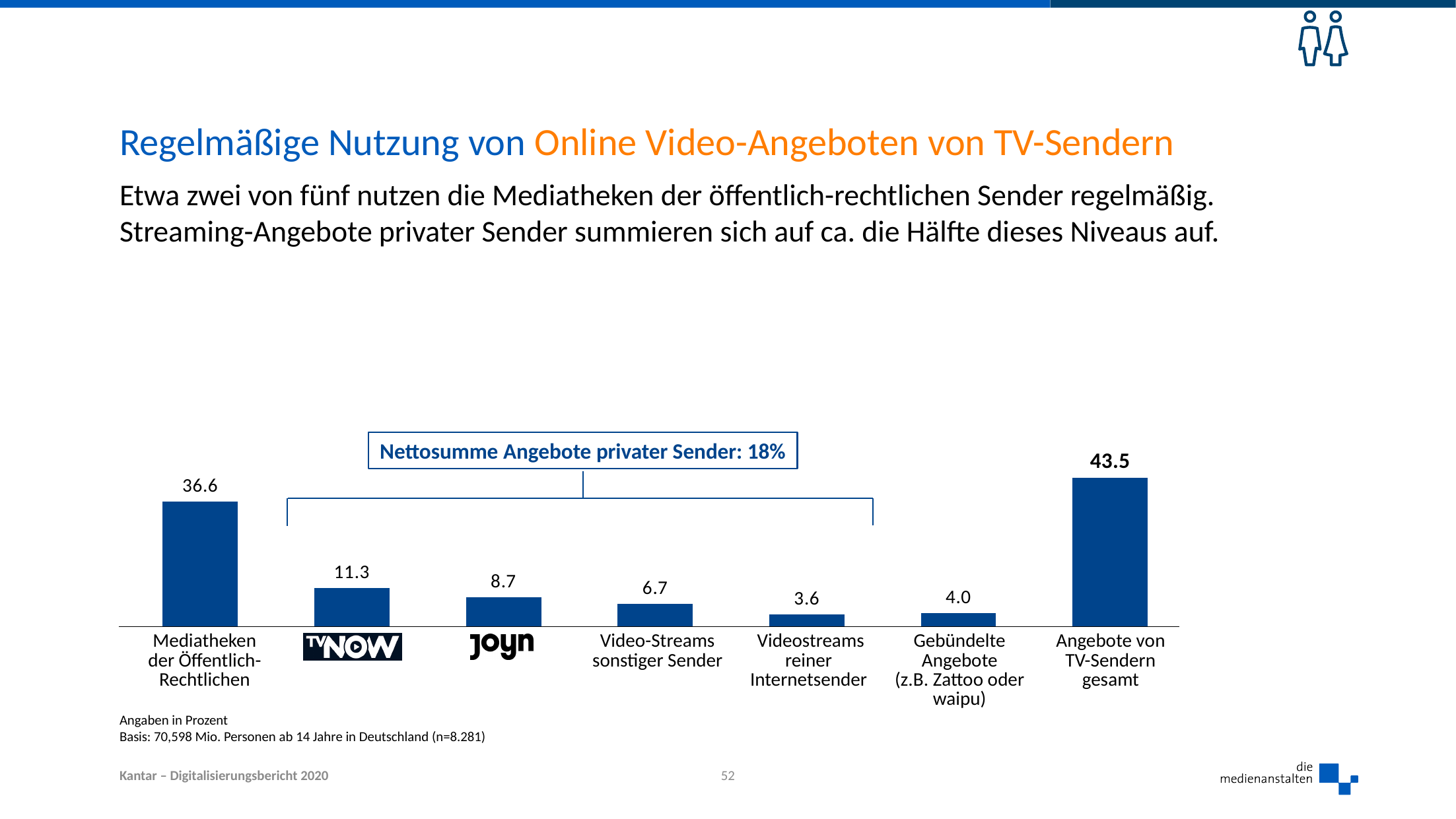
Which category has the highest value? Angebote von TV-Sendern gesamt Which is larger, the value for joyn or the value for Video-Streams sonstiger Sender? joyn What net sum is given for the offerings of private broadcasters (Nettosumme Angebote privater Sender)? 18% What is the difference between the values for Mediatheken der Öffentlich-Rechtlichen and TV NOW? 25.3 What is the difference between the values for Video-Streams sonstiger Sender and Videostreams reiner Internetsender? 3.1 What is the value for Angebote von TV-Sendern gesamt? 43.5 Which category has the lowest value? Videostreams reiner Internetsender What kind of chart is shown on the slide? bar chart What is the value for Mediatheken der Öffentlich-Rechtlichen? 36.6 What is the value for TV NOW? 11.3 How many categories are shown in the chart? 7 What is the value for Gebündelte Angebote (z.B. Zattoo oder waipu)? 4.0